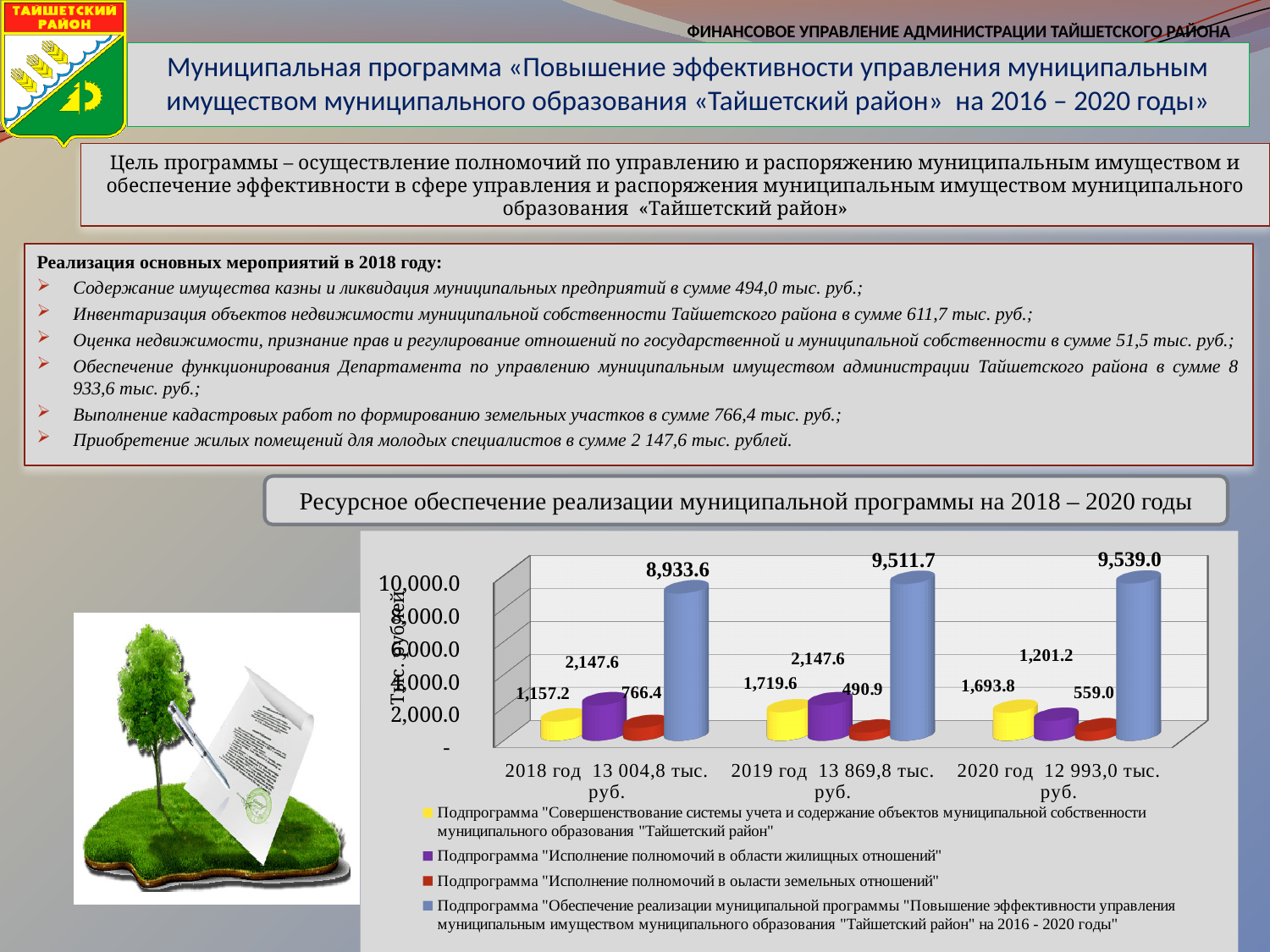
What is the value for the subprogram "Исполнение полномочий в области земельных отношений" in 2019 год? 490.9 What is the value for the subprogram "Совершенствование системы учета и содержание объектов муниципальной собственности..." in 2019 год? 1,719.6 What is the title of the vertical axis of the chart? Тыс. рублей What is the value for the subprogram "Исполнение полномочий в области жилищных отношений" in 2020 год? 1,201.2 What type of chart is shown on the slide? bar chart Which is larger: the 2018 value or the 2020 value for the subprogram "Исполнение полномочий в области жилищных отношений"? 2018 value How many year categories are shown on the x axis of the chart? 3 In which year is the value for the subprogram "Исполнение полномочий в области земельных отношений" the lowest? 2019 год How many series does the chart legend list? 4 What is the value for the subprogram "Обеспечение реализации муниципальной программы..." in 2018 год? 8,933.6 What is the difference between the 2019 and 2018 values for the subprogram "Обеспечение реализации муниципальной программы..."? 578.1 In which year is the value for the subprogram "Обеспечение реализации муниципальной программы..." the highest? 2020 год